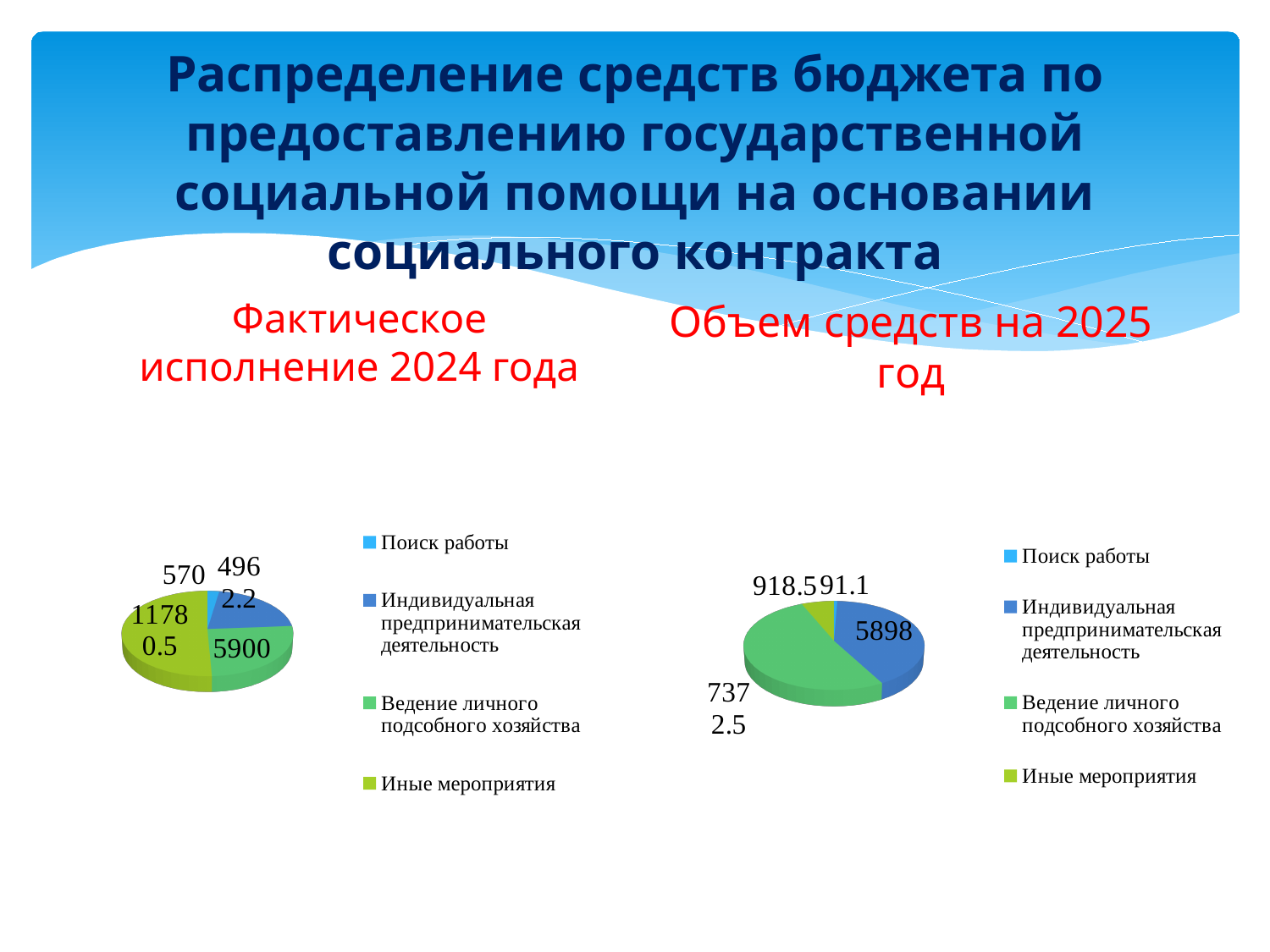
In the left chart 'Фактическое исполнение 2024 года', which is larger: 'Ведение личного подсобного хозяйства' or 'Поиск работы'? Ведение личного подсобного хозяйства What kind of chart is the right chart, 'Объем средств на 2025 год'? Pie chart What colour represents 'Иные мероприятия' in the legends? Yellow-green In the left chart 'Фактическое исполнение 2024 года', what is the value for 'Ведение личного подсобного хозяйства'? 5900 What kind of chart is the left chart, 'Фактическое исполнение 2024 года'? Pie chart How many entries does the legend of the left chart 'Фактическое исполнение 2024 года' list? 4 In the right chart 'Объем средств на 2025 год', what is the value for 'Индивидуальная предпринимательская деятельность'? 5898 In the right chart 'Объем средств на 2025 год', which category has the largest slice? Ведение личного подсобного хозяйства In the left chart 'Фактическое исполнение 2024 года', what is the value for 'Поиск работы'? 570 In the left chart 'Фактическое исполнение 2024 года', which category has the smallest slice? Поиск работы What is the title above the left pie chart? Фактическое исполнение 2024 года How many pie charts are shown on the slide? 2